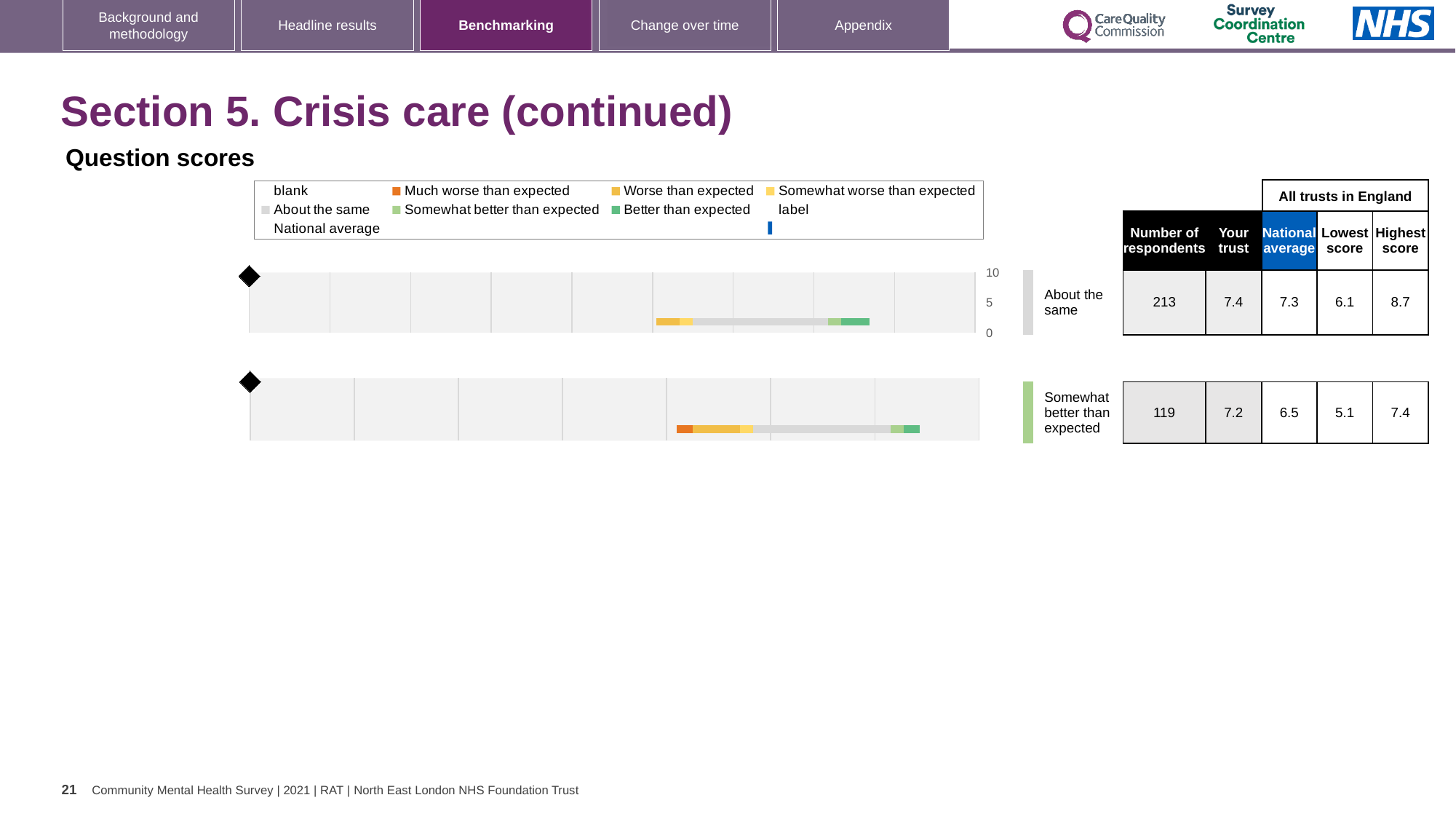
Which chart row has more respondents, the top row or the bottom row? top row For the top chart row (rated 'About the same'), what is the lowest score among all trusts in England? 6.1 How many question score charts (rows) are shown on the slide? 2 For the top chart row (rated 'About the same'), which is larger: the 'Your trust' score or the national average? Your trust What is the highest value shown on the vertical axis of the top chart? 10 What kind of chart is used to show the question scores on this slide? bar chart In the legend, which colour represents 'Much worse than expected'? orange For the bottom chart row (rated 'Somewhat better than expected'), what is the highest score among all trusts in England? 7.4 For the top chart row (rated 'About the same'), what is the 'Your trust' score? 7.4 For the top chart row (rated 'About the same'), what is the number of respondents? 213 For the bottom chart row (rated 'Somewhat better than expected'), what is the difference between the highest score and the lowest score? 2.3 For the bottom chart row (rated 'Somewhat better than expected'), what is the national average score? 6.5